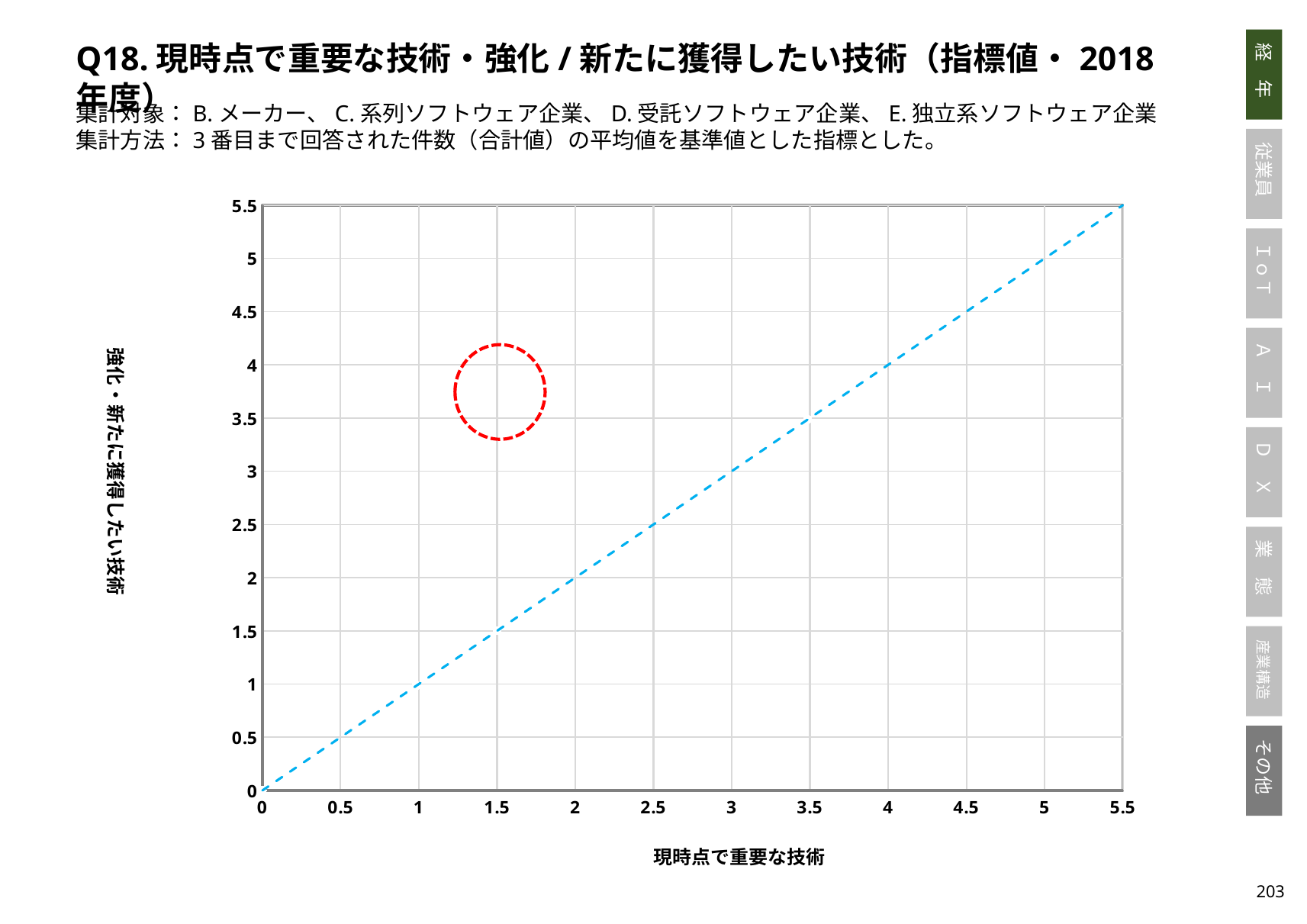
What y value does the blue dashed line pass through at x = 3? 3 What is the title of the horizontal (x) axis of the chart? 現時点で重要な技術 What kind of chart is shown on the slide? scatter chart What y value does the blue dashed line reach at x = 5.5? 5.5 What is the highest value labelled on the y axis? 5.5 What y value does the blue dashed line have at x = 0? 0 What is the highest value labelled on the x axis? 5.5 Is the y value of the blue dashed line at x = 2 greater or less than 3? less Is the y value of the blue dashed line at x = 4.5 greater or less than 4? greater Does the blue dashed line rise or fall as the x-axis value increases? rise What is the title of the vertical (y) axis of the chart? 強化・新たに獲得したい技術